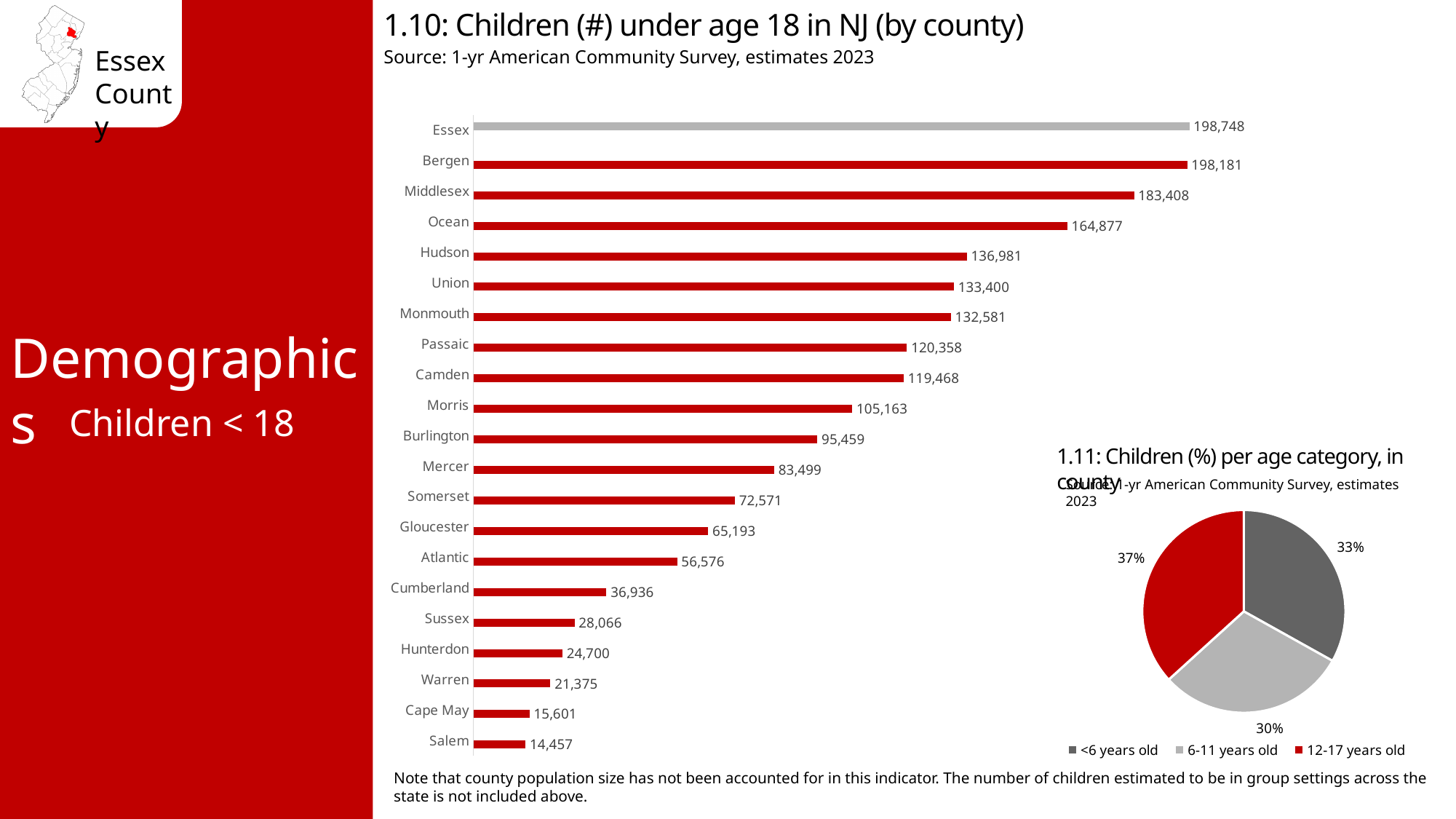
In chart 1.10, how many counties are shown? 21 In chart 1.11, what percentage of children are 12-17 years old? 37% What type of chart is chart 1.10? Bar chart In chart 1.10, what is the value for Ocean County? 164,877 In chart 1.10, what is the difference between the values for Essex and Bergen? 567 In chart 1.10, which county has more children under 18, Passaic or Camden? Passaic How many categories does the legend of chart 1.11 list? 3 In chart 1.10, which county has the lowest number of children under 18? Salem In chart 1.11, which age category has the largest share? 12-17 years old In chart 1.11, what percentage of children are 6-11 years old? 30% In chart 1.10, how many children under age 18 are in Essex County? 198,748 In chart 1.10, which county has the highest number of children under 18? Essex